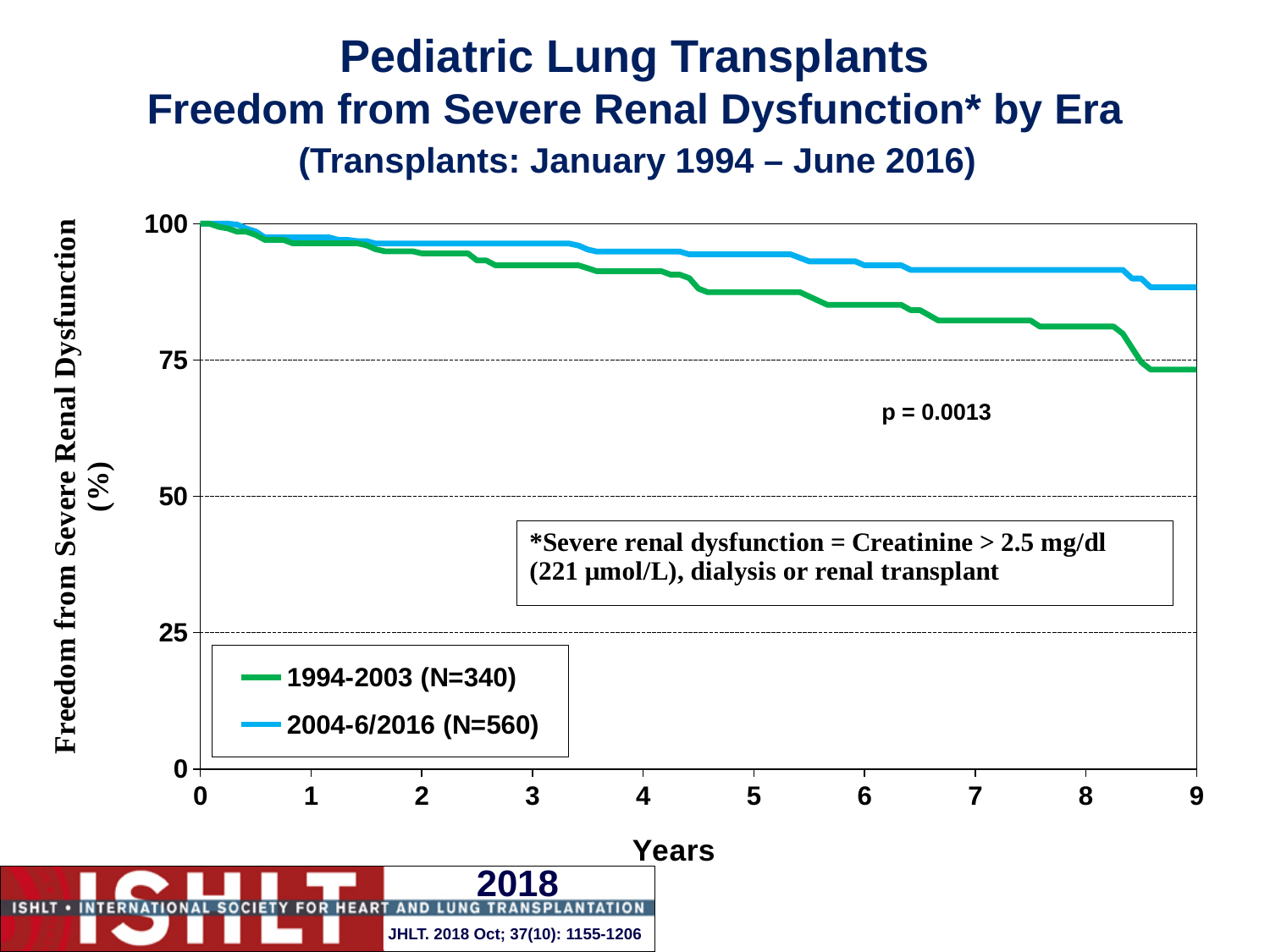
Is the value for the 1994-2003 series at year 9 greater or less than 75? less What is the value of both series at year 0? 100 What p-value is shown on the chart? p = 0.0013 Do the values for the 1994-2003 series rise or fall as years increase? fall Do the values for the 2004-6/2016 series rise or fall as years increase? fall At year 6, which series is higher, 1994-2003 or 2004-6/2016? 2004-6/2016 Is the value for the 2004-6/2016 series at year 9 greater or less than 75? greater What kind of chart is shown on the slide? line chart How many series does the legend list? 2 At year 9, which series has the higher freedom from severe renal dysfunction, 1994-2003 or 2004-6/2016? 2004-6/2016 Is the value for the 1994-2003 series at year 5 greater or less than 75? greater What is the N for the 1994-2003 series in the legend? N=340